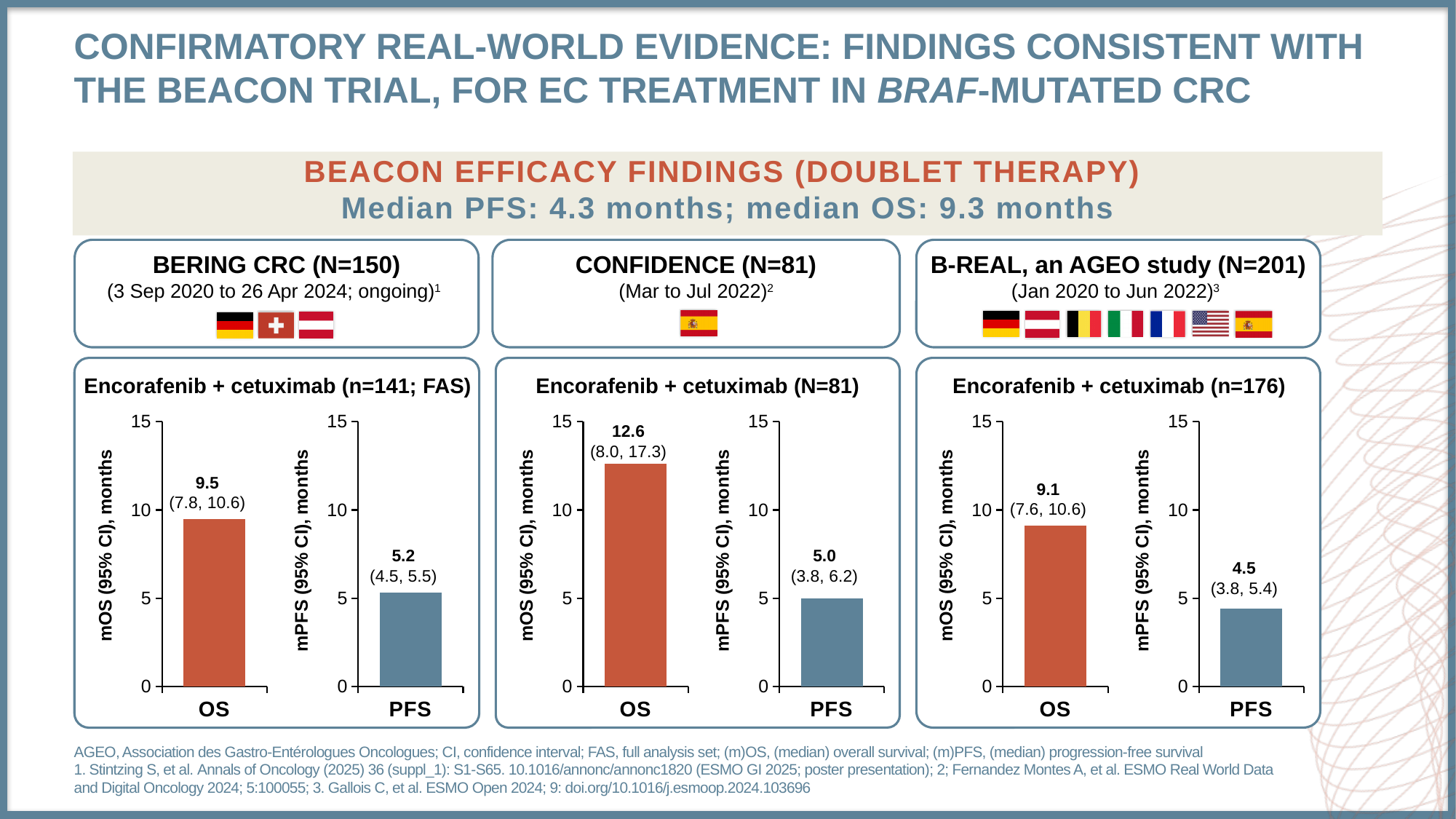
Across the three study panels, which study shows the highest median OS? CONFIDENCE Which is larger: the median OS in BERING CRC or the median OS in B-REAL? BERING CRC (9.5) In the CONFIDENCE panel, is the median OS bar greater or less than 10 on the axis? greater In the BERING CRC panel, what is the median OS value shown for encorafenib + cetuximab? 9.5 In the B-REAL panel, what is the 95% CI printed for the median PFS bar? (3.8, 5.4) Across the three study panels, which study shows the lowest median PFS? B-REAL What colour are the mOS bars in the three panels? orange-red What type of chart is used to display the OS and PFS values in each panel? bar chart In the B-REAL panel, what is the median OS value shown? 9.1 What is the maximum value shown on the y-axis of the OS and PFS charts? 15 In the CONFIDENCE panel, what is the median PFS value shown? 5.0 In the CONFIDENCE panel, what is the difference between the median OS and median PFS values? 7.6